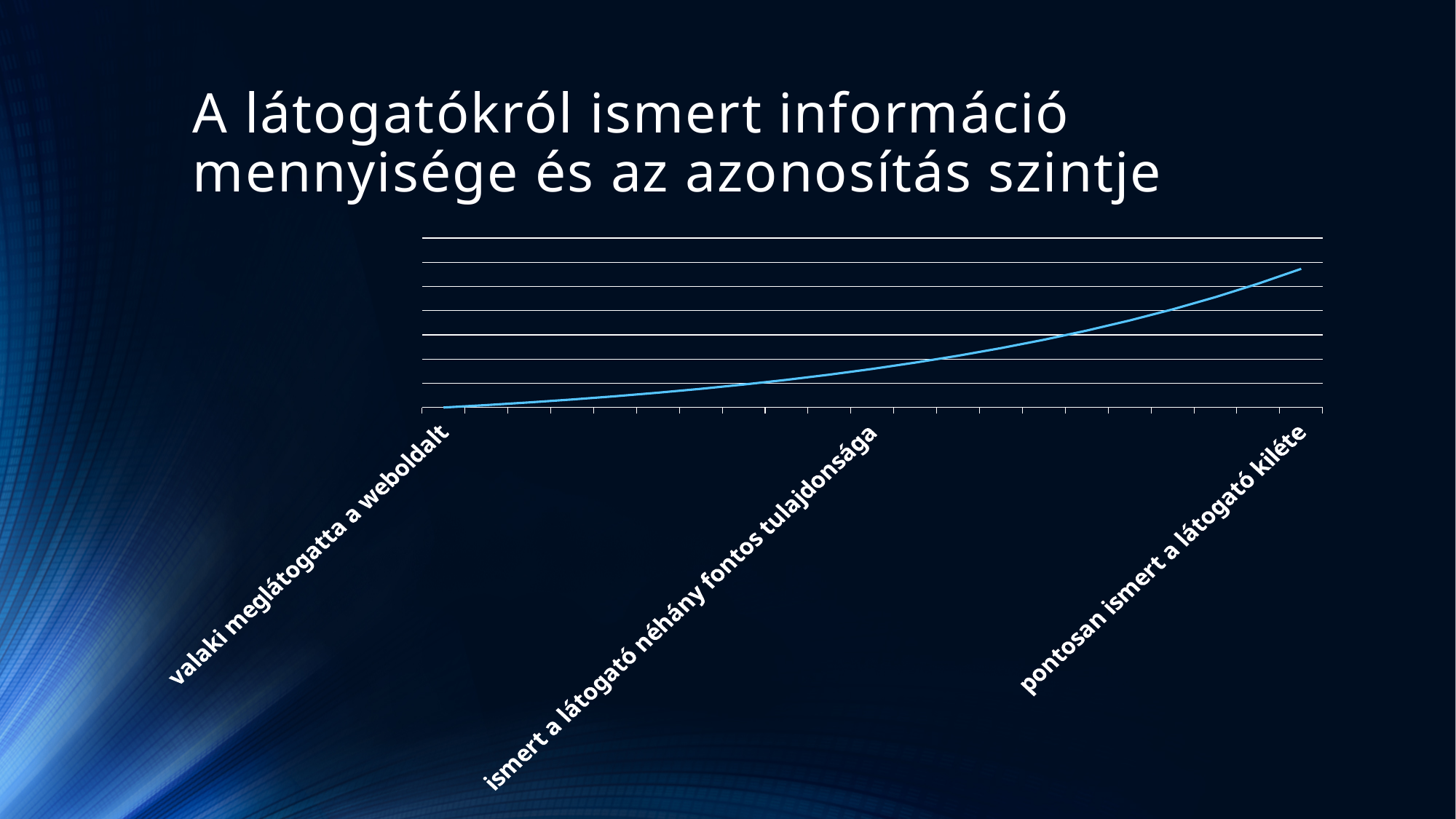
Which has the larger value: 'ismert a látogató néhány fontos tulajdonsága' or 'valaki meglátogatta a weboldalt'? ismert a látogató néhány fontos tulajdonsága Do the values rise or fall along the x axis from left to right? rise Which has the larger value: 'pontosan ismert a látogató kiléte' or 'ismert a látogató néhány fontos tulajdonsága'? pontosan ismert a látogató kiléte What kind of chart is shown on the slide? line chart What is the title of the slide containing the chart? A látogatókról ismert információ mennyisége és az azonosítás szintje Which labelled category has the highest value on the line? pontosan ismert a látogató kiléte Which labelled category has the lowest value on the line? valaki meglátogatta a weboldalt What is the label of the first category on the x axis? valaki meglátogatta a weboldalt How many labelled categories are shown on the x axis? 3